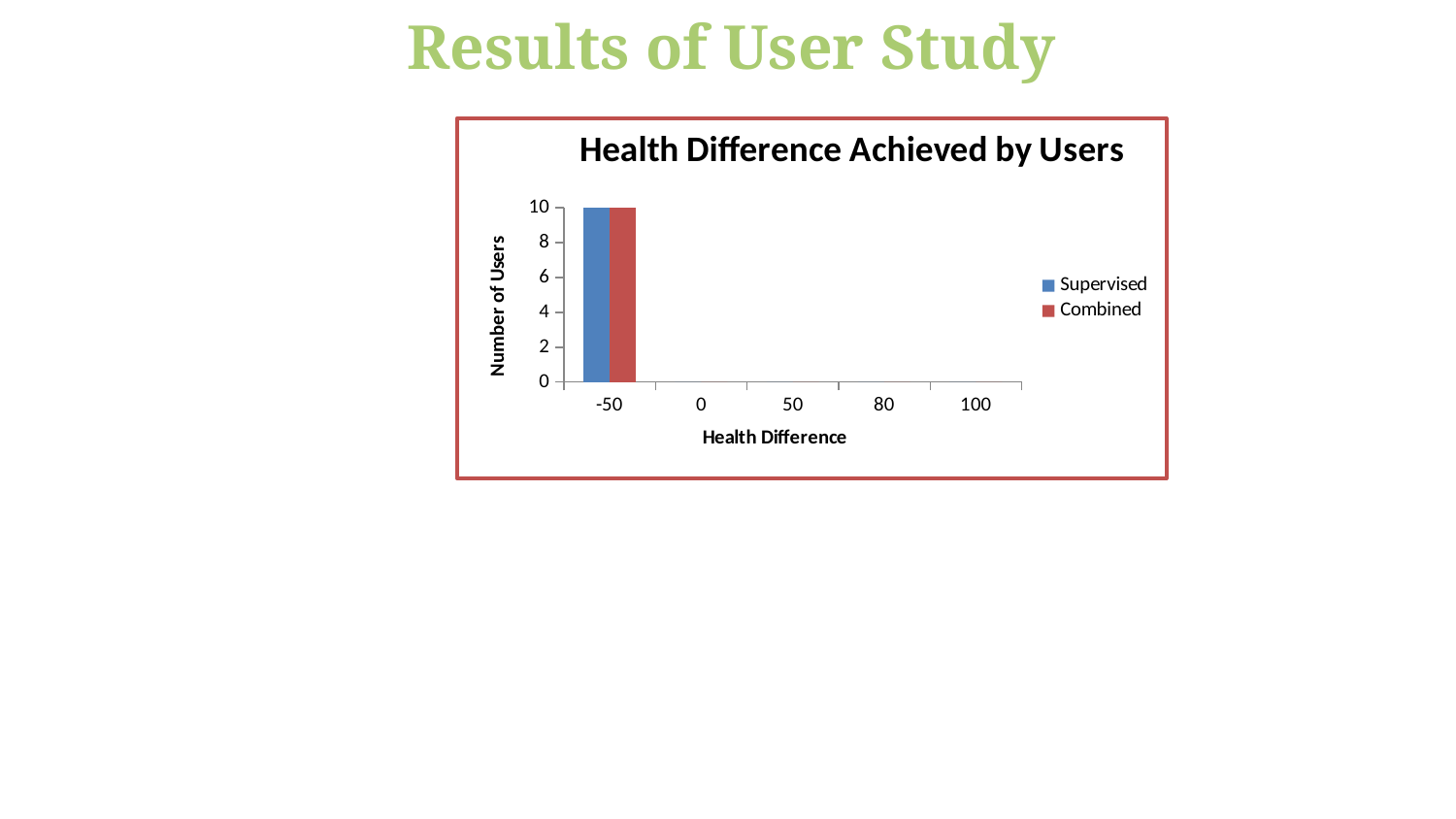
How many categories are shown on the x axis? 5 What is the number of users for the Combined series at a health difference of -50? 10 What is the difference between the Supervised and Combined values at a health difference of -50? 0 What is the number of users for the Supervised series at a health difference of -50? 10 What is the label of the y axis? Number of Users Which health difference category has the highest number of users for the Supervised series? -50 What is the title of the chart? Health Difference Achieved by Users How many series does the legend list? 2 Which health difference category has the highest number of users for the Combined series? -50 What kind of chart is shown on the slide? bar chart Is the number of users for the Supervised series at -50 greater or less than 5? greater